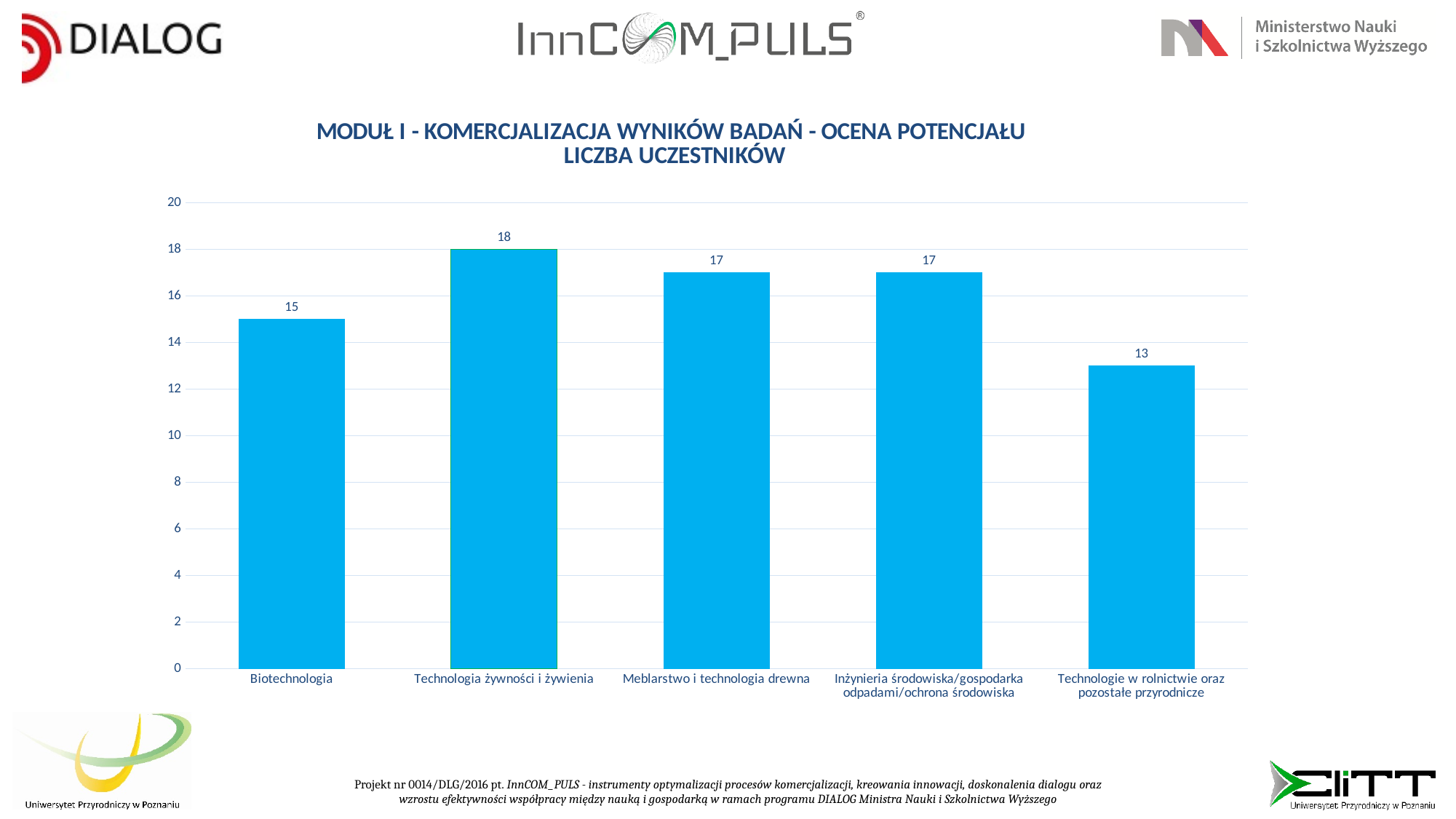
Which category has the lowest number of participants? Technologie w rolnictwie oraz pozostałe przyrodnicze What kind of chart is shown on the slide? Bar chart What is the number of participants for Biotechnologia? 15 What is the difference between the number of participants for Inżynieria środowiska/gospodarka odpadami/ochrona środowiska and Technologie w rolnictwie oraz pozostałe przyrodnicze? 4 Which has more participants, Biotechnologia or Meblarstwo i technologia drewna? Meblarstwo i technologia drewna What is the number of participants for Technologie w rolnictwie oraz pozostałe przyrodnicze? 13 What is the number of participants for Meblarstwo i technologia drewna? 17 Which category has the highest number of participants? Technologia żywności i żywienia What is the maximum value shown on the vertical axis? 20 What is the difference between the number of participants for Technologia żywności i żywienia and Biotechnologia? 3 How many categories are shown on the chart? 5 What is the number of participants for Technologia żywności i żywienia? 18